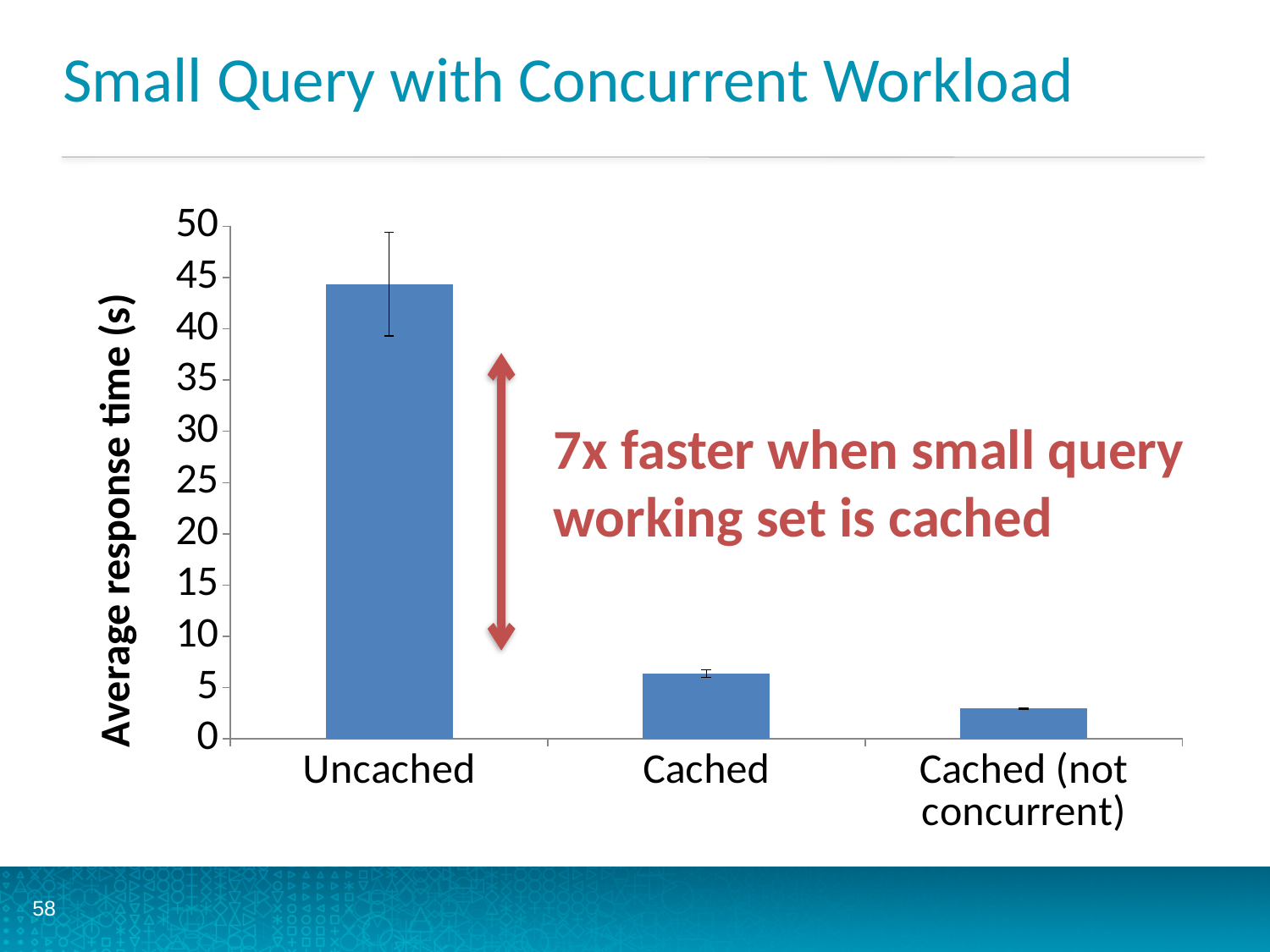
What is the label of the y axis? Average response time (s) How many categories are shown on the x axis? 3 Is the value for Uncached greater or less than 40? greater Which category has the highest average response time? Uncached Do the values rise or fall from left to right along the x axis? fall Which category has the lowest average response time? Cached (not concurrent) Is the value for Cached (not concurrent) greater or less than 5? less Which is larger, the value for Cached or the value for Cached (not concurrent)? Cached What is the title of the slide containing the chart? Small Query with Concurrent Workload Which is larger, the value for Uncached or the value for Cached? Uncached Is the value for Cached greater or less than 10? less What kind of chart is shown on the slide? bar chart